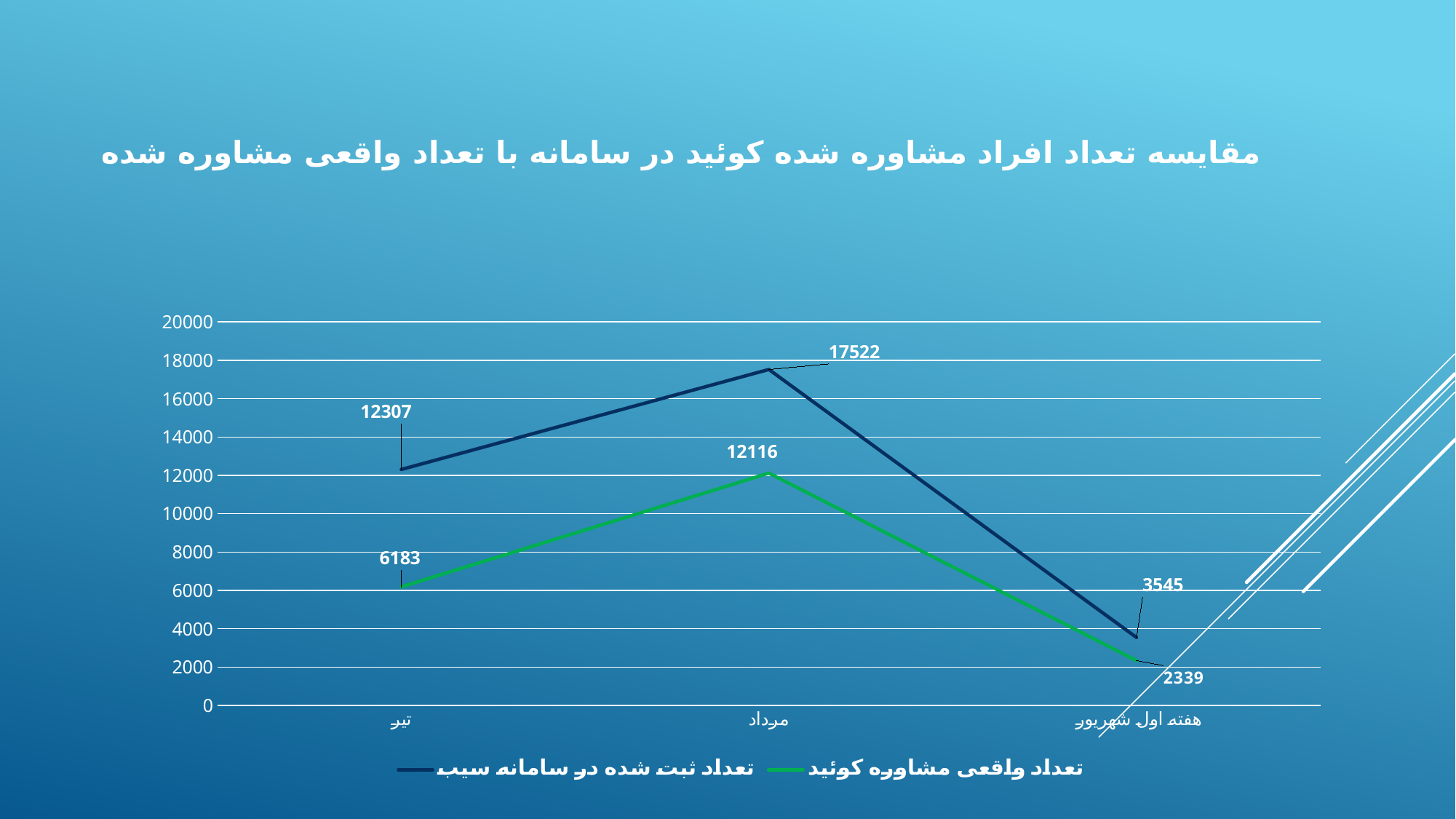
Which category has the highest value for the dark blue series (تعداد ثبت شده در سامانه سیب)? مرداد How many series does the legend list? 2 What is the value of the green series (تعداد واقعی مشاوره کوئید) for تیر? 6183 What is the value of the green series (تعداد واقعی مشاوره کوئید) for هفته اول شهریور? 2339 What is the value of the dark blue series (تعداد ثبت شده در سامانه سیب) for مرداد? 17522 What type of chart is shown on the slide? line chart What is the difference between the dark blue and green series values for مرداد? 5406 Which is larger for تیر: the dark blue series (تعداد ثبت شده در سامانه سیب) or the green series (تعداد واقعی مشاوره کوئید)? تعداد ثبت شده در سامانه سیب Which category has the lowest value for the green series (تعداد واقعی مشاوره کوئید)? هفته اول شهریور Does the dark blue series rise or fall from مرداد to هفته اول شهریور? fall What colour is the line for تعداد واقعی مشاوره کوئید? green How many categories are shown on the x axis? 3